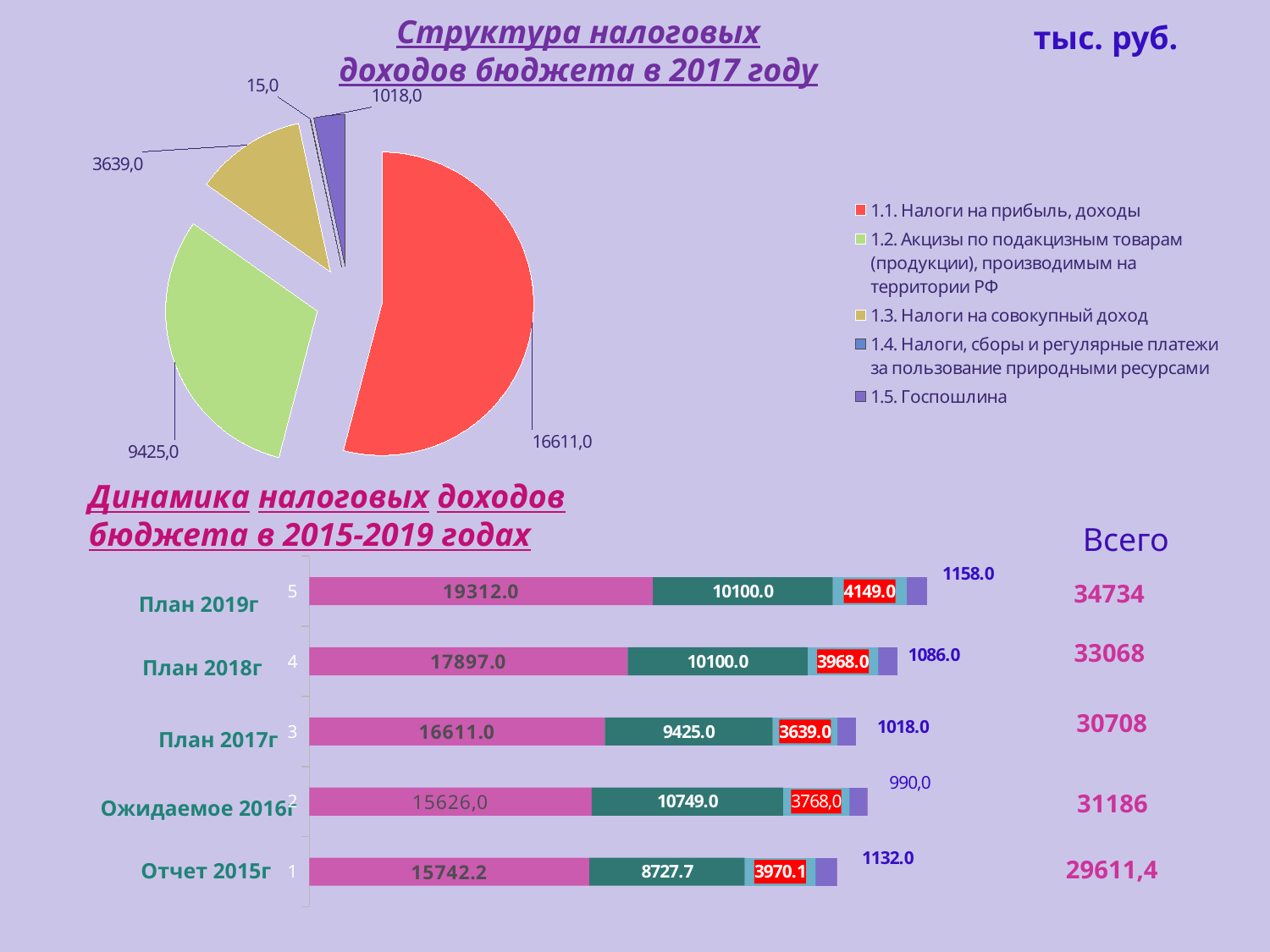
What kind of chart is the bottom chart, 'Динамика налоговых доходов бюджета в 2015-2019 годах'? bar chart What kind of chart is the top chart, 'Структура налоговых доходов бюджета в 2017 году'? pie chart In the pie chart 'Структура налоговых доходов бюджета в 2017 году', which category has the largest slice? 1.1. Налоги на прибыль, доходы How many categories does the legend of the pie chart 'Структура налоговых доходов бюджета в 2017 году' list? 5 In the pie chart 'Структура налоговых доходов бюджета в 2017 году', what is the difference between the values for '1.1. Налоги на прибыль, доходы' and '1.2. Акцизы по подакцизным товарам'? 7186,0 In the pie chart 'Структура налоговых доходов бюджета в 2017 году', which category has the smallest slice? 1.4. Налоги, сборы и регулярные платежи за пользование природными ресурсами In the bar chart 'Динамика налоговых доходов бюджета в 2015-2019 годах', which is larger: the first (pink) segment for 'План 2019г' or for 'План 2018г'? План 2019г How many categories (years) are shown in the bar chart 'Динамика налоговых доходов бюджета в 2015-2019 годах'? 5 In the bar chart 'Динамика налоговых доходов бюджета в 2015-2019 годах', what is the value of the first (pink) segment for 'План 2019г'? 19312.0 In the pie chart 'Структура налоговых доходов бюджета в 2017 году', what is the value for '1.1. Налоги на прибыль, доходы'? 16611,0 In the bar chart 'Динамика налоговых доходов бюджета в 2015-2019 годах', what is the total ('Всего') for 'План 2018г'? 33068 In the pie chart 'Структура налоговых доходов бюджета в 2017 году', what is the value for '1.3. Налоги на совокупный доход'? 3639,0